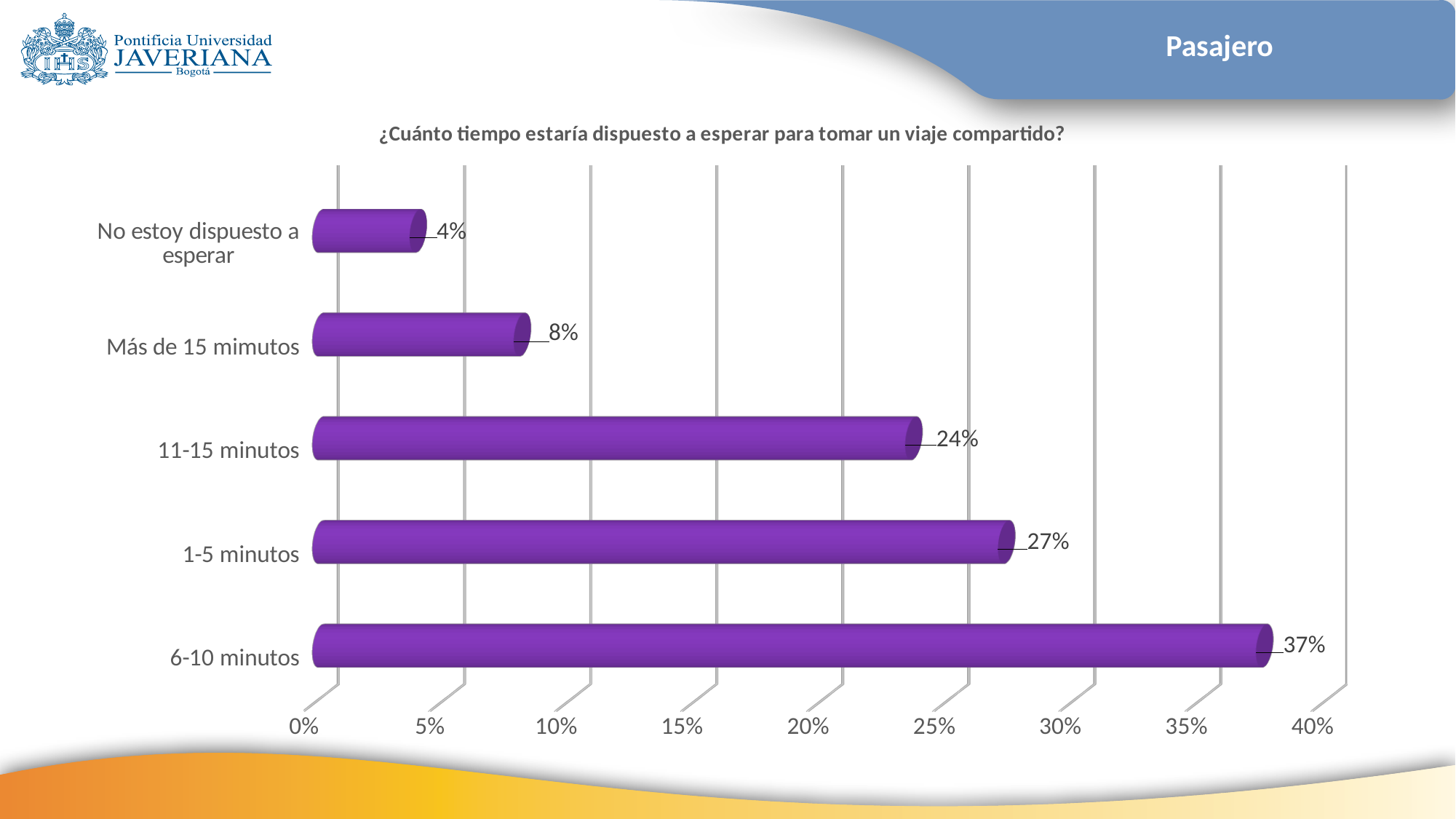
What is the value for "11-15 minutos"? 24% What is the title of the chart? ¿Cuánto tiempo estaría dispuesto a esperar para tomar un viaje compartido? What is the value for "1-5 minutos"? 27% Which category has the lowest value? No estoy dispuesto a esperar What is the value for "Más de 15 mimutos"? 8% Which category has the highest value? 6-10 minutos What is the value for "6-10 minutos"? 37% What kind of chart is shown on the slide? Bar chart Which is larger, the value for "11-15 minutos" or the value for "Más de 15 mimutos"? 11-15 minutos What is the difference between the values for "6-10 minutos" and "1-5 minutos"? 10% How many categories does the chart show? 5 What is the value for "No estoy dispuesto a esperar"? 4%